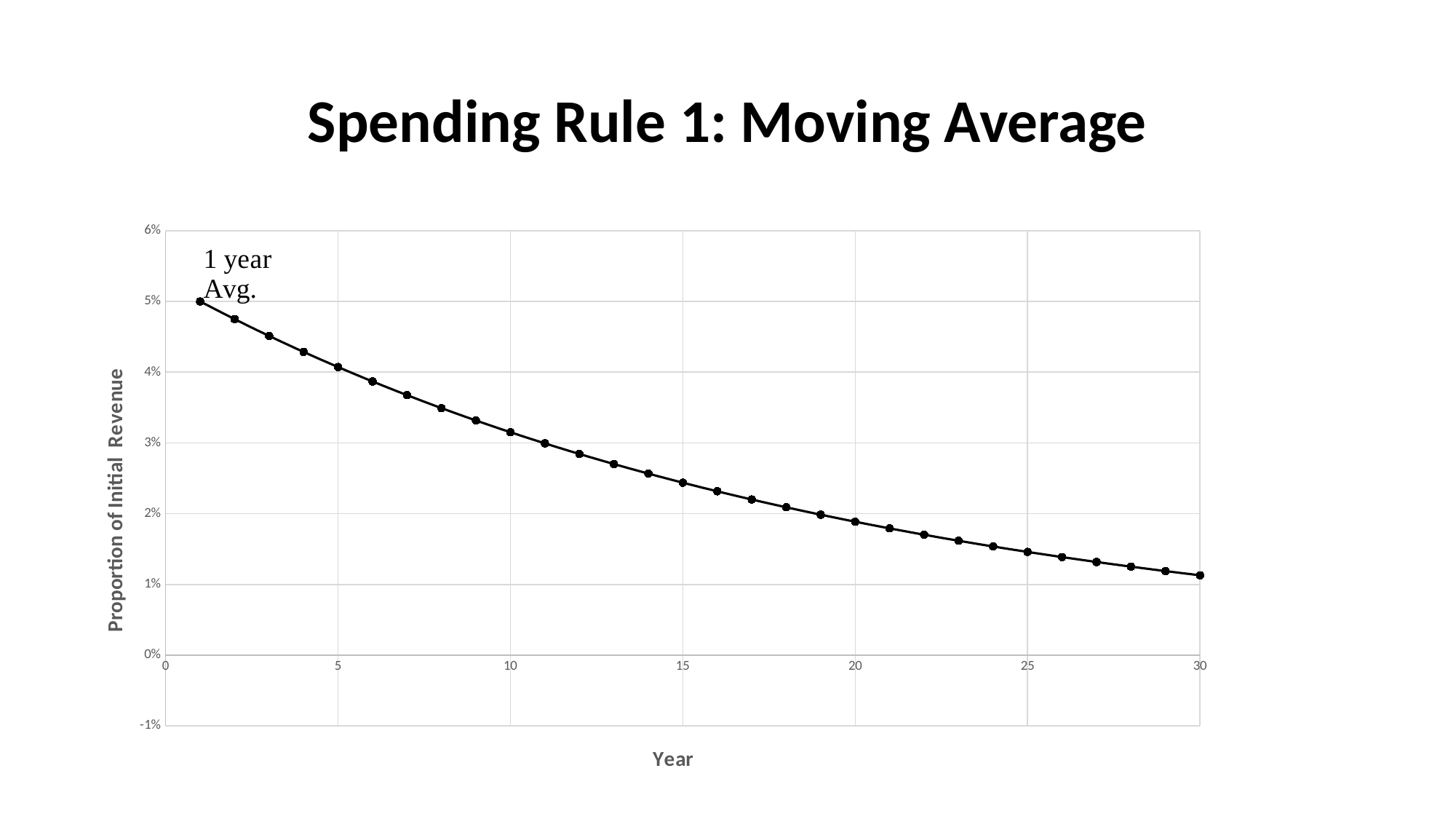
At which year is the proportion of initial revenue highest? 1 Is the value at year 30 greater or less than 1%? greater Which is larger, the value at year 5 or the value at year 25? year 5 Do the values rise or fall as the year increases along the x axis? fall Is the value at year 20 greater or less than 2%? less What is the title of the vertical axis? Proportion of Initial Revenue What annotation text is placed next to the first data point? 1 year Avg. What kind of chart is shown on the slide? line chart Is the value at year 10 greater or less than 3%? greater What is the proportion of initial revenue at year 1? 5% How many data points are plotted on the line? 30 At which year is the proportion of initial revenue lowest? 30